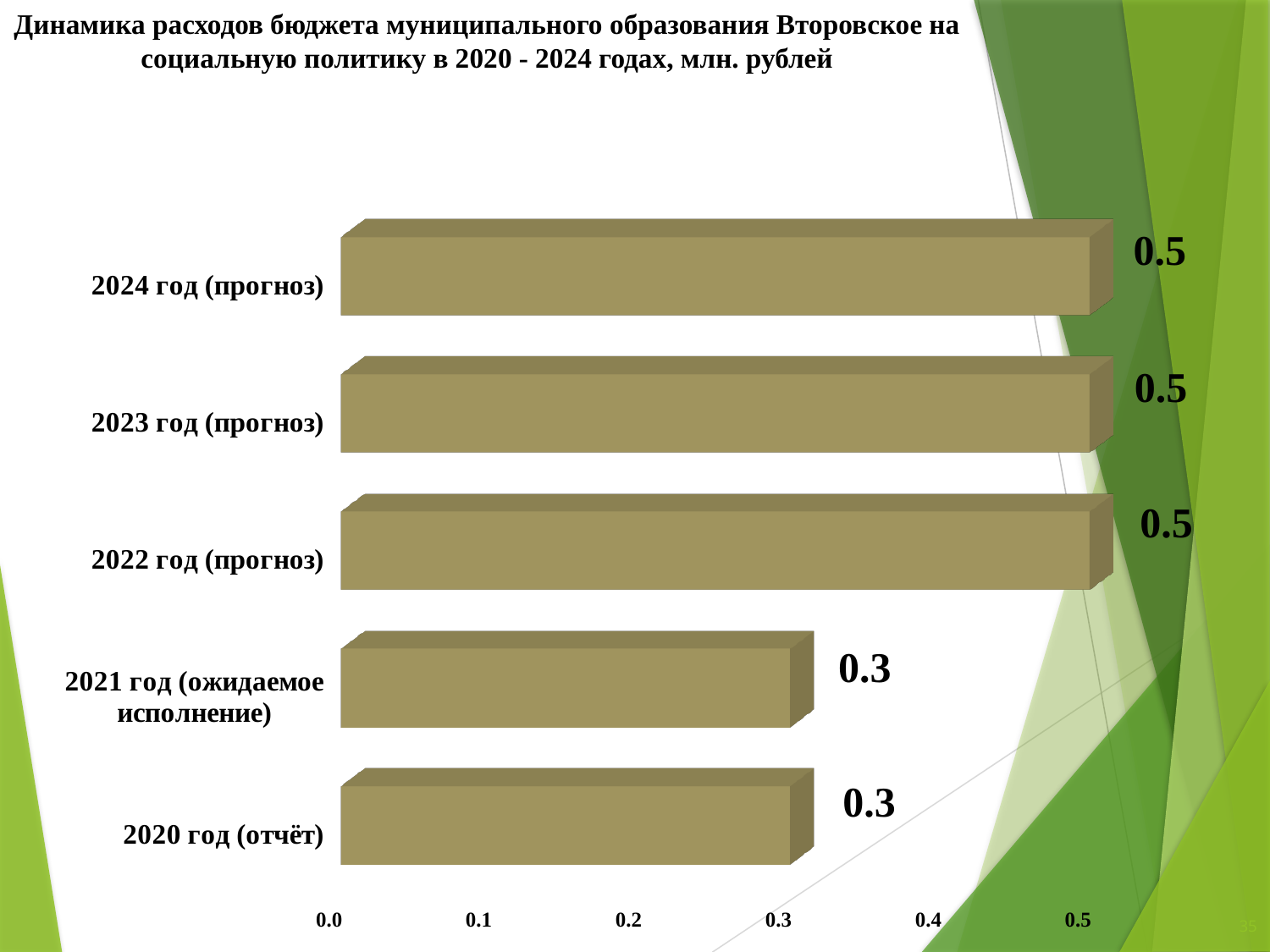
Do the values rise or fall from 2020 to 2024? rise What is the value for 2021 год (ожидаемое исполнение)? 0.3 How many categories are shown on the chart? 5 What kind of chart is shown on the slide? bar chart What is the value for 2024 год (прогноз)? 0.5 What is the value for 2022 год (прогноз)? 0.5 Which is larger, the value for 2023 год (прогноз) or the value for 2020 год (отчёт)? 2023 год (прогноз) Is the value for 2020 год (отчёт) greater or less than 0.4? less What is the lowest value shown on the chart? 0.3 What is the difference between the values for 2022 год (прогноз) and 2021 год (ожидаемое исполнение)? 0.2 What is the value for 2020 год (отчёт)? 0.3 What is the highest value shown on the chart? 0.5